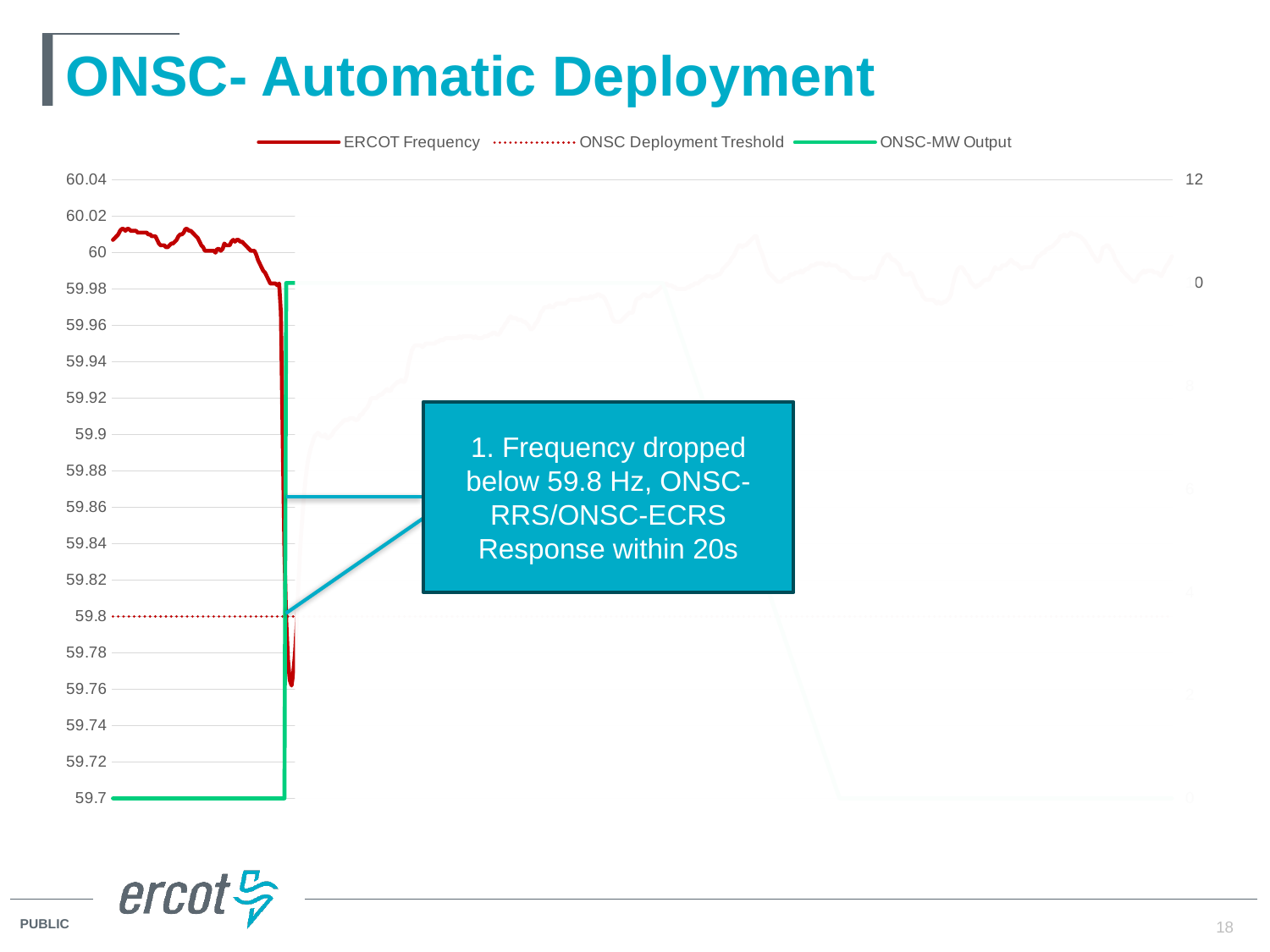
How many series does the chart legend list? 3 Is the lowest point of the ERCOT Frequency line greater or less than 59.8? less What kind of chart is shown on the slide? line chart What is the highest value shown on the left vertical axis? 60.04 Is the ERCOT Frequency at the start of the chart greater or less than 60? greater What is the lowest value shown on the left vertical axis? 59.7 Which series is drawn as a dotted line in the legend? ONSC Deployment Treshold According to the callout, below what frequency did the frequency drop to trigger the ONSC response? 59.8 Hz Does the ERCOT Frequency line rise or fall just before the ONSC-MW Output line jumps up? fall Is the lowest point of the ERCOT Frequency line greater or less than 59.74? greater Which series is drawn in green? ONSC-MW Output At what frequency value on the left axis is the ONSC Deployment Threshold line drawn? 59.8